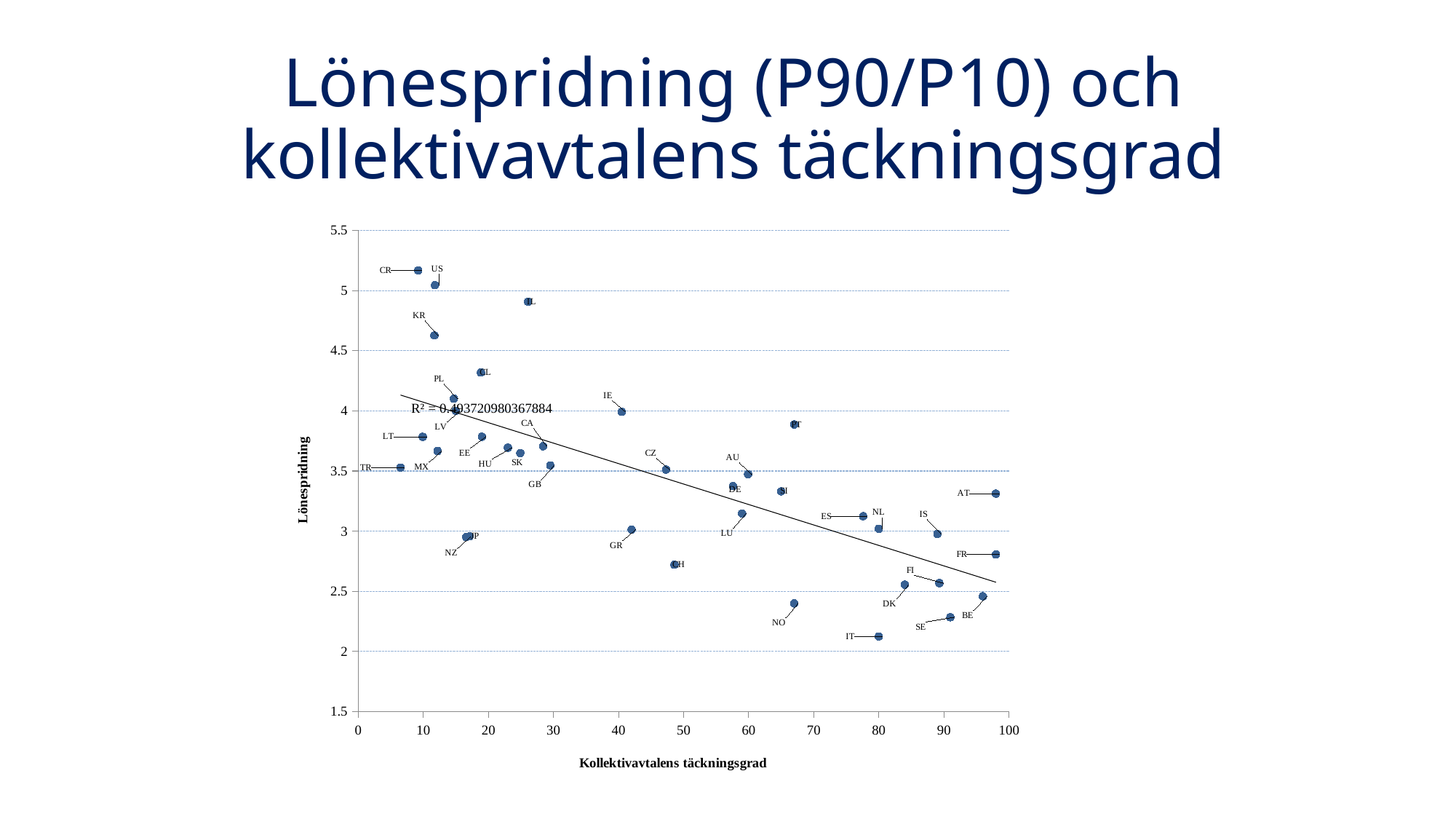
Which has a higher Lönespridning value, KR or PL? KR What kind of chart is shown on the slide? Scatter chart Which country has the lowest Lönespridning value in the chart? IT Is the Lönespridning value for FR greater or less than 3? less Is the Lönespridning value for PL greater or less than 4? greater Is the Lönespridning value for CR greater or less than 5? greater As Kollektivavtalens täckningsgrad increases along the x axis, does Lönespridning generally rise or fall according to the trend line? Fall What R² value is printed on the chart? R² = 0.493720980367884 Which country has the highest Lönespridning value in the chart? CR Which has a higher Lönespridning value, IE or GR? IE